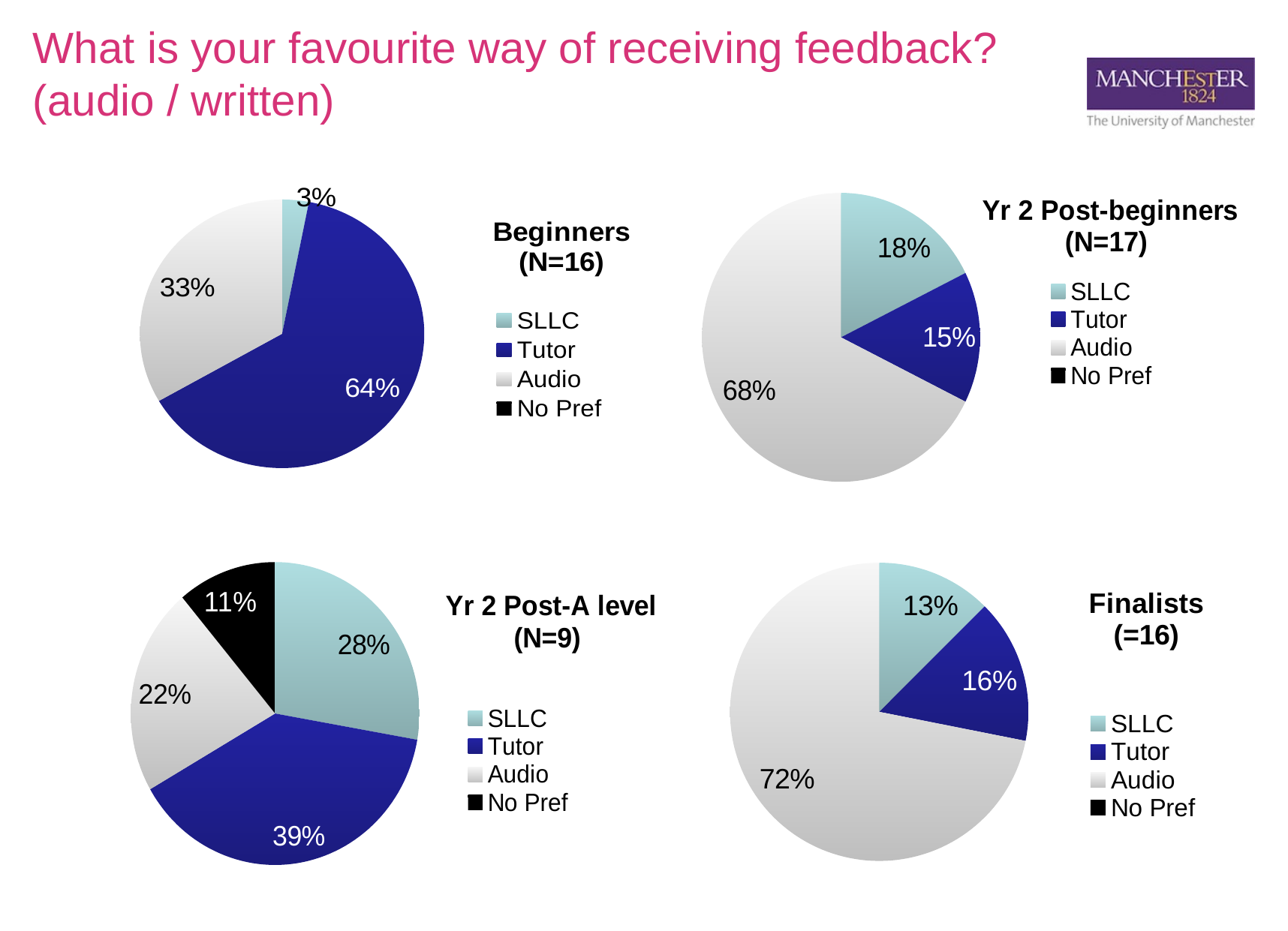
In the Finalists (=16) pie chart, what is the difference between the Tutor and SLLC percentages? 3% How many entries does the legend of the Finalists (=16) pie chart list? 4 What type of chart is used for the Beginners (N=16) data? Pie chart In the Yr 2 Post-A level (N=9) pie chart, what percentage is shown for No Pref? 11% In the Beginners (N=16) pie chart, what percentage is shown for Audio? 33% In the Yr 2 Post-beginners (N=17) pie chart, what percentage is shown for Audio? 68% In the Yr 2 Post-A level (N=9) pie chart, which category has the largest slice? Tutor In the Finalists (=16) pie chart, what percentage is shown for Audio? 72% In the Beginners (N=16) pie chart, which category has the smallest labelled slice? SLLC In the Yr 2 Post-beginners (N=17) pie chart, which is larger, SLLC or Tutor? SLLC In the Beginners (N=16) pie chart, what share of the pie is Tutor? 64% In the Yr 2 Post-A level (N=9) pie chart, what is the difference between the Tutor and SLLC percentages? 11%